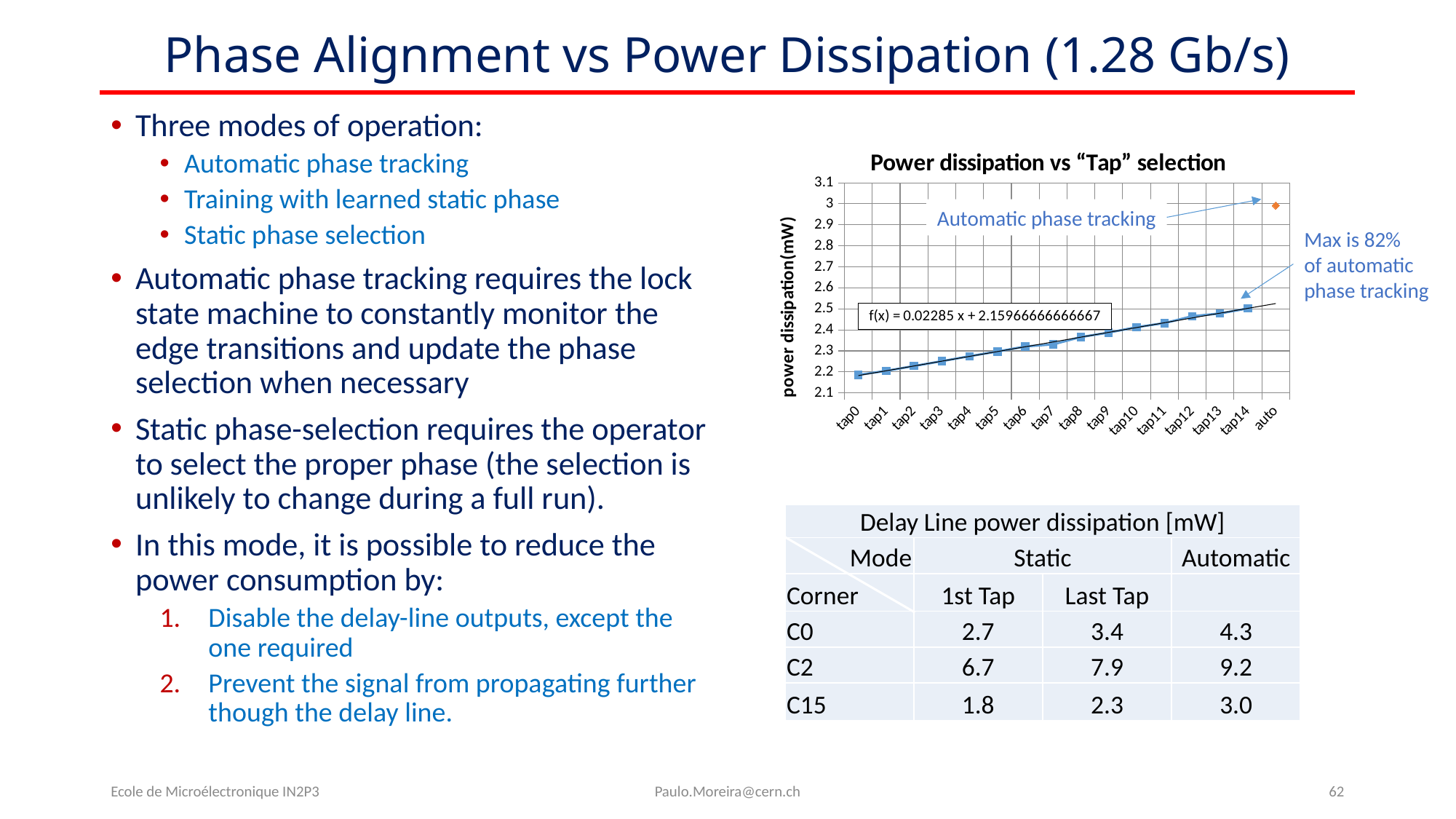
How many points are plotted along the x axis of the chart? 16 What is the trendline equation printed on the chart? f(x) = 0.02285 x + 2.15966666666667 Do the power dissipation values rise or fall from tap0 to tap14? rise Which x-axis category has the highest power dissipation in the chart? auto Is the power dissipation for auto greater or less than 2.9? greater Which x-axis category has the lowest power dissipation in the chart? tap0 Is the power dissipation for tap0 greater or less than 2.3? less Is the power dissipation for tap14 greater or less than 2.4? greater What kind of chart is shown on the slide? scatter chart Which has the larger power dissipation, tap10 or tap2? tap10 What is the title of the chart on the slide? Power dissipation vs "Tap" selection